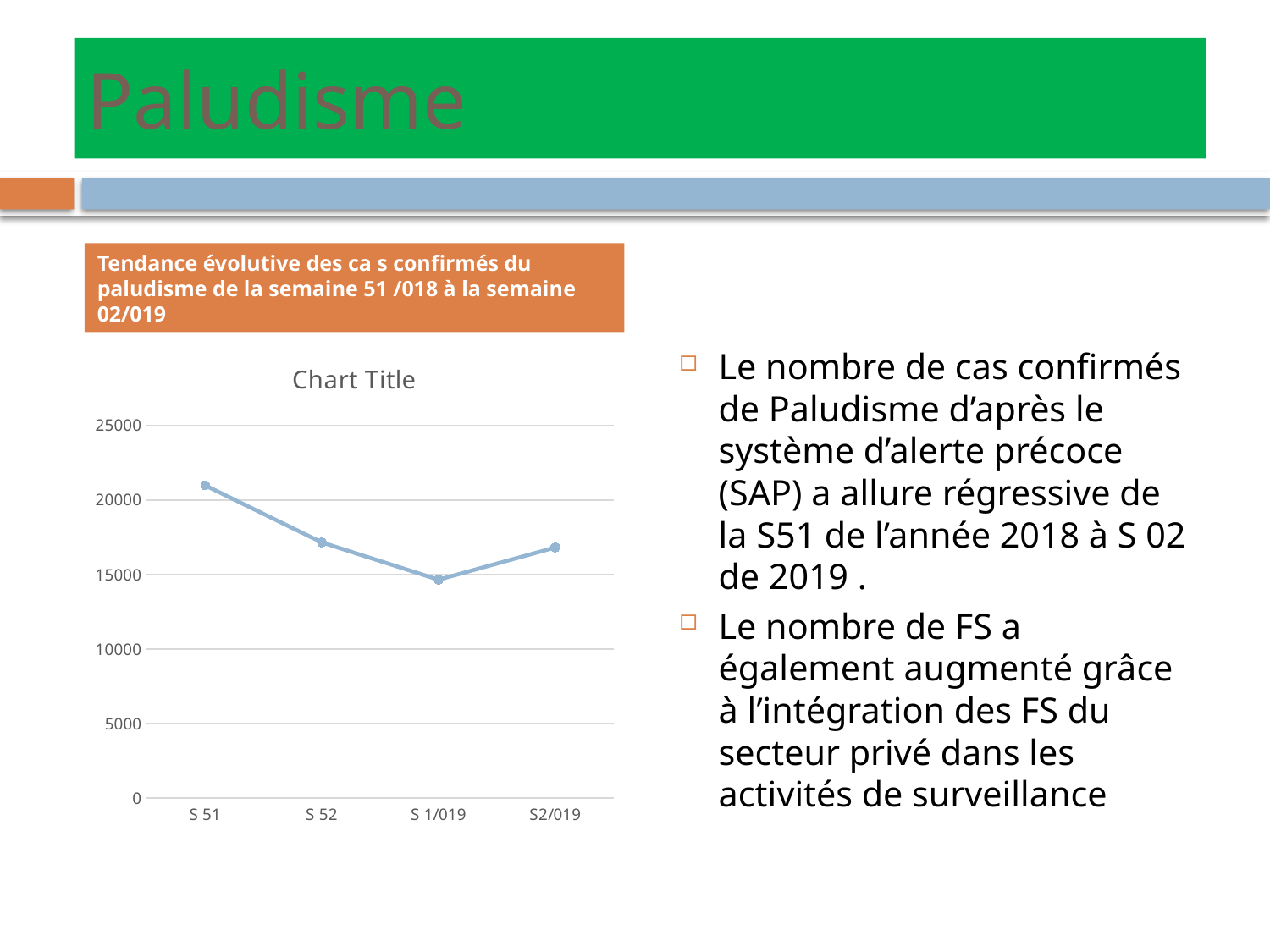
What kind of chart is shown on the slide? line chart Is the value for S 51 greater or less than 20000? greater Is the value for S 52 greater or less than 20000? less How many data points are plotted on the line chart? 4 What is the title printed above the line chart? Chart Title Is the value for S2/019 greater or less than 15000? greater Which category has the highest value on the line chart? S 51 Which is larger, the value for S 1/019 or the value for S2/019? S2/019 Do the values rise or fall from S 51 to S 1/019? fall Which is larger, the value for S 51 or the value for S 52? S 51 Which category has the lowest value on the line chart? S 1/019